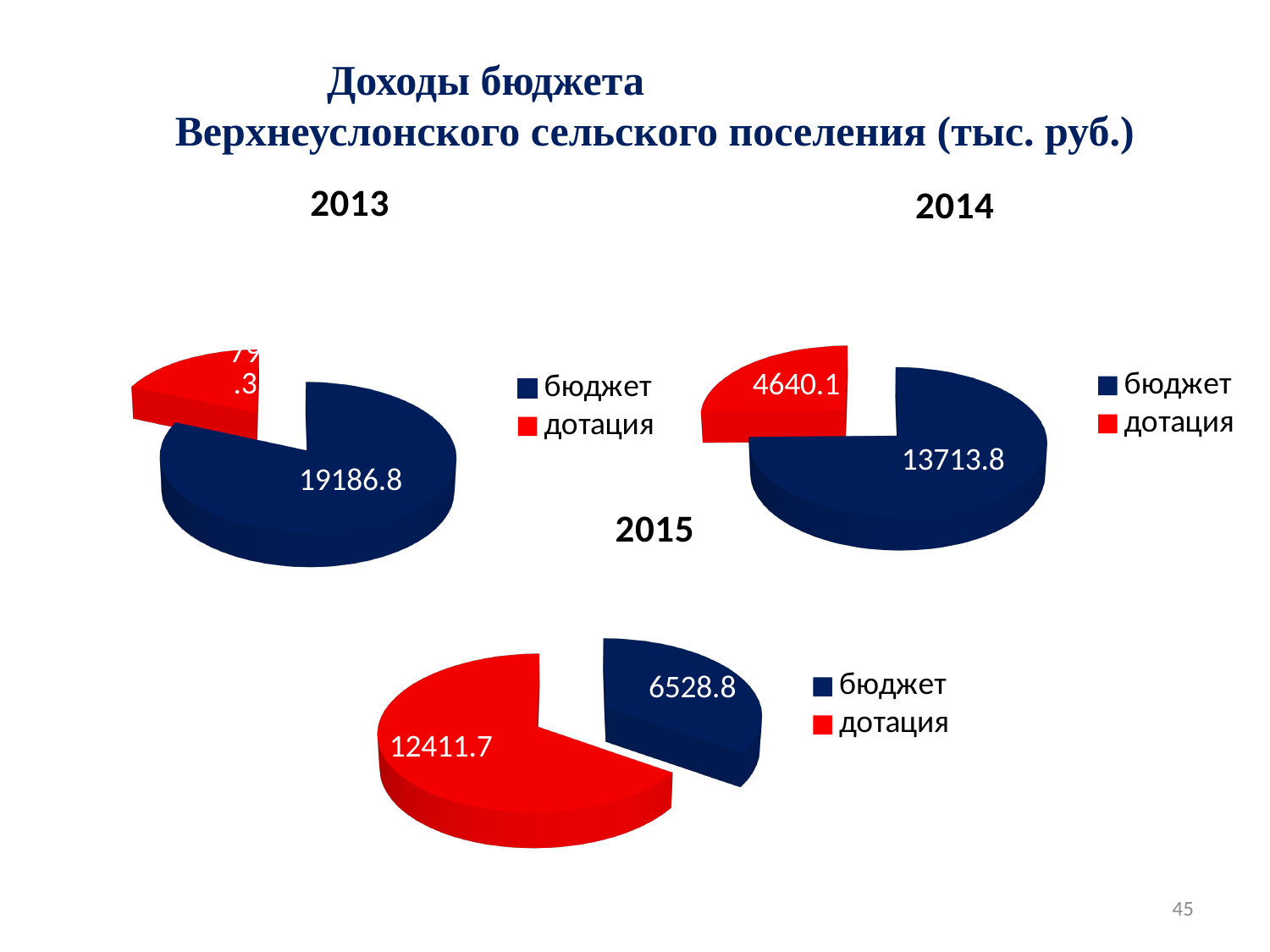
In the 2014 pie chart, which category has the smallest slice? дотация In the 2013 pie chart, what is the value for бюджет? 19186.8 In the 2014 pie chart, what is the value for бюджет? 13713.8 In the 2014 pie chart, what is the difference between бюджет and дотация? 9073.7 Which is larger: бюджет in the 2013 pie chart or бюджет in the 2014 pie chart? бюджет in 2013 What kind of chart is used for the 2014 data on the slide? pie chart In the 2015 pie chart, what is the value for дотация? 12411.7 In the 2014 pie chart, what is the value for дотация? 4640.1 In the 2015 pie chart, what is the value for бюджет? 6528.8 In the 2015 pie chart, what is the difference between дотация and бюджет? 5882.9 In the 2015 pie chart, which category has the largest slice? дотация How many entries does the legend of the 2015 pie chart list? 2